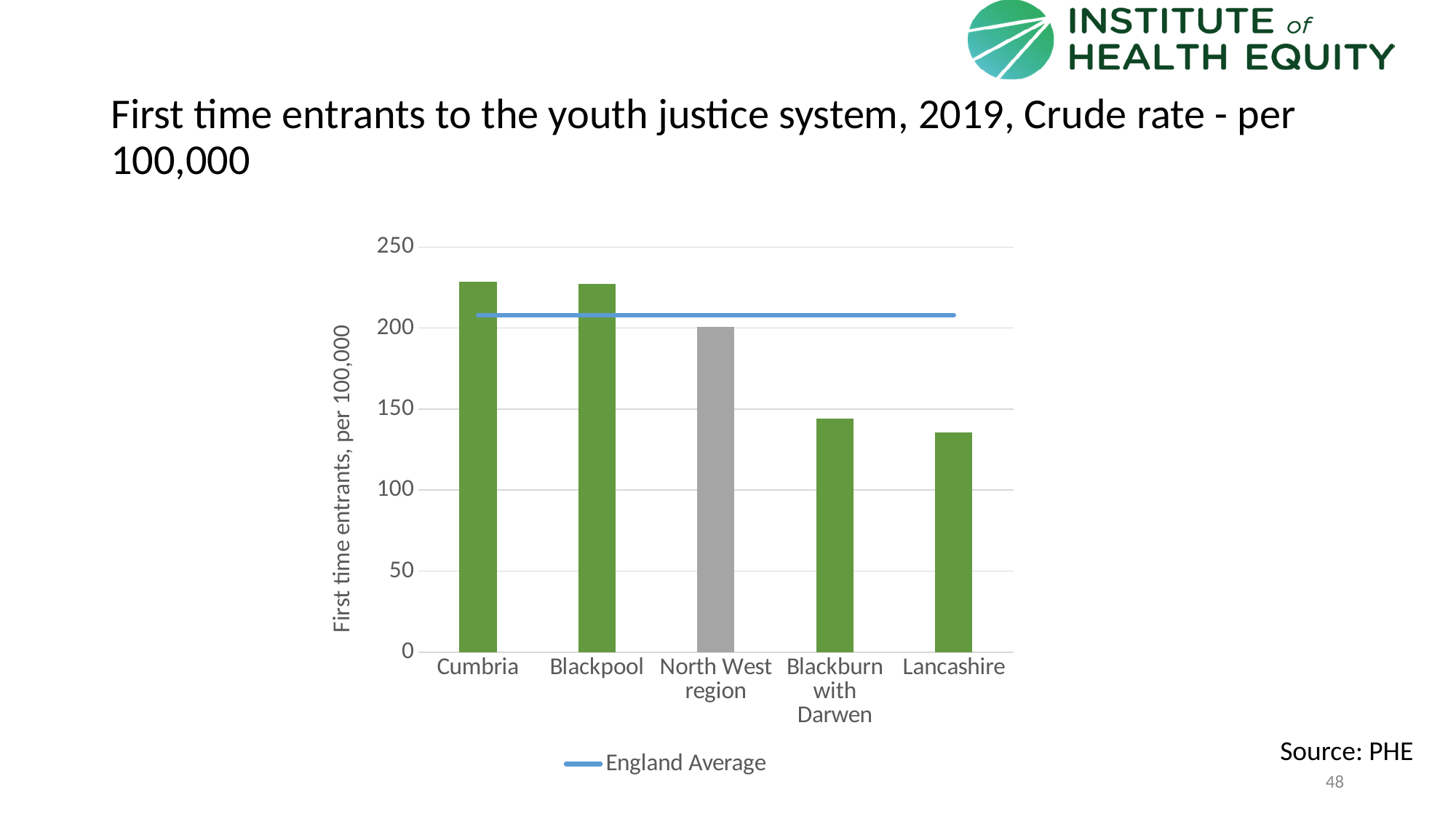
Do the bar values generally rise or fall from left to right along the x axis? fall Which has a larger value, North West region or Lancashire? North West region Which has a larger value, Blackpool or Blackburn with Darwen? Blackpool How many categories are shown on the x axis of the chart? 5 Is the value for Cumbria greater or less than 200? greater What kind of chart is shown on the slide? bar chart Is the value for Blackburn with Darwen greater or less than 150? less Which category has the lowest value in the chart? Lancashire How many series does the chart's legend list? 1 Is the value for Lancashire greater or less than 150? less What does the blue horizontal line in the chart represent, according to the legend? England Average